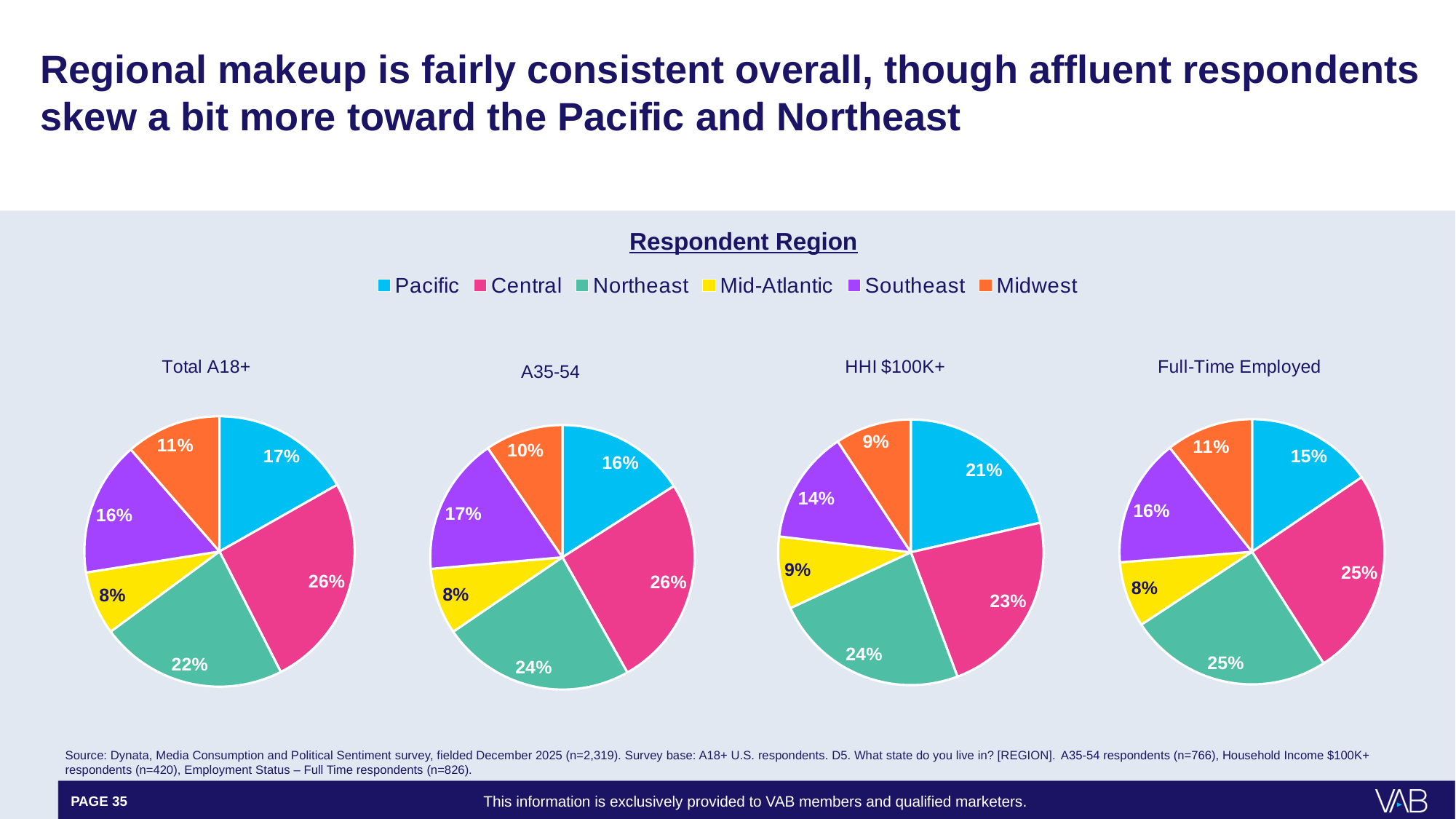
In the Full-Time Employed pie chart, which is larger: the Pacific share or the Southeast share? Southeast In the HHI $100K+ pie chart, what share of respondents are from the Pacific region? 21% What type of chart is used to show the respondent region breakdown? Pie chart In the A35-54 pie chart, which region has the largest share? Central In the Total A18+ pie chart, what share of respondents are from the Central region? 26% How many pie charts are shown on the slide? 4 How many regions does the legend list? 6 In the Full-Time Employed pie chart, what share of respondents are from the Southeast region? 16% In the A35-54 pie chart, what is the difference between the Central share and the Midwest share? 16 percentage points In the Total A18+ pie chart, which region has the smallest share? Mid-Atlantic In the HHI $100K+ pie chart, which region has the largest share? Northeast What colour represents the Midwest region in the legend? Orange